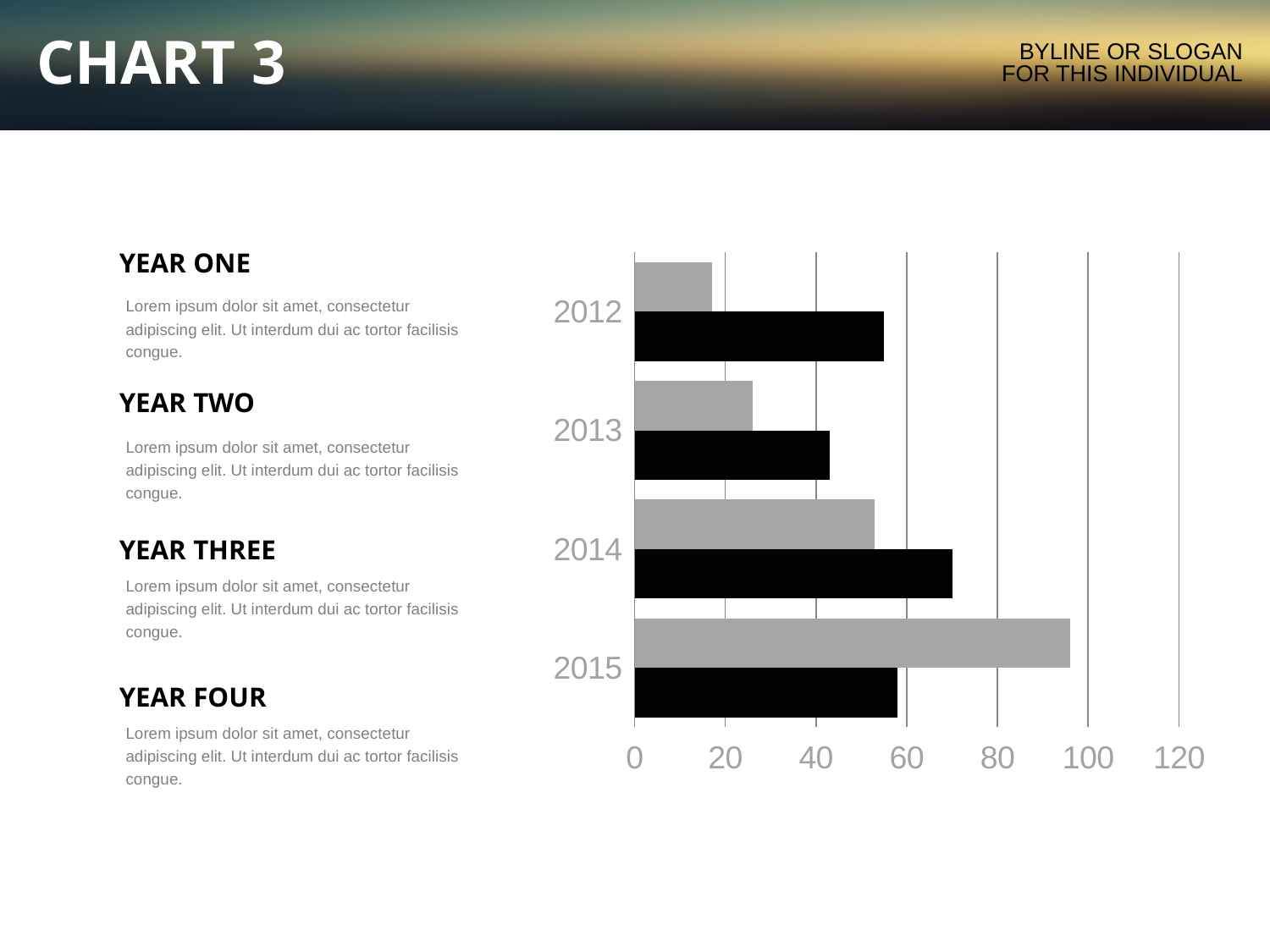
Do the gray bars get longer or shorter from 2012 to 2015? longer Is the gray bar for 2012 greater or less than 20? less Which year has the shortest black bar? 2013 For 2012, which bar is longer, the gray bar or the black bar? the black bar How many bars are plotted for each year on the chart? 2 Which year has the longest gray bar? 2015 How many year categories are shown on the chart? 4 Which year has the longest black bar? 2014 Is the gray bar for 2015 greater or less than 80? greater Is the black bar for 2014 greater or less than 60? greater What kind of chart is shown on the slide? bar chart Which year has the shortest gray bar? 2012